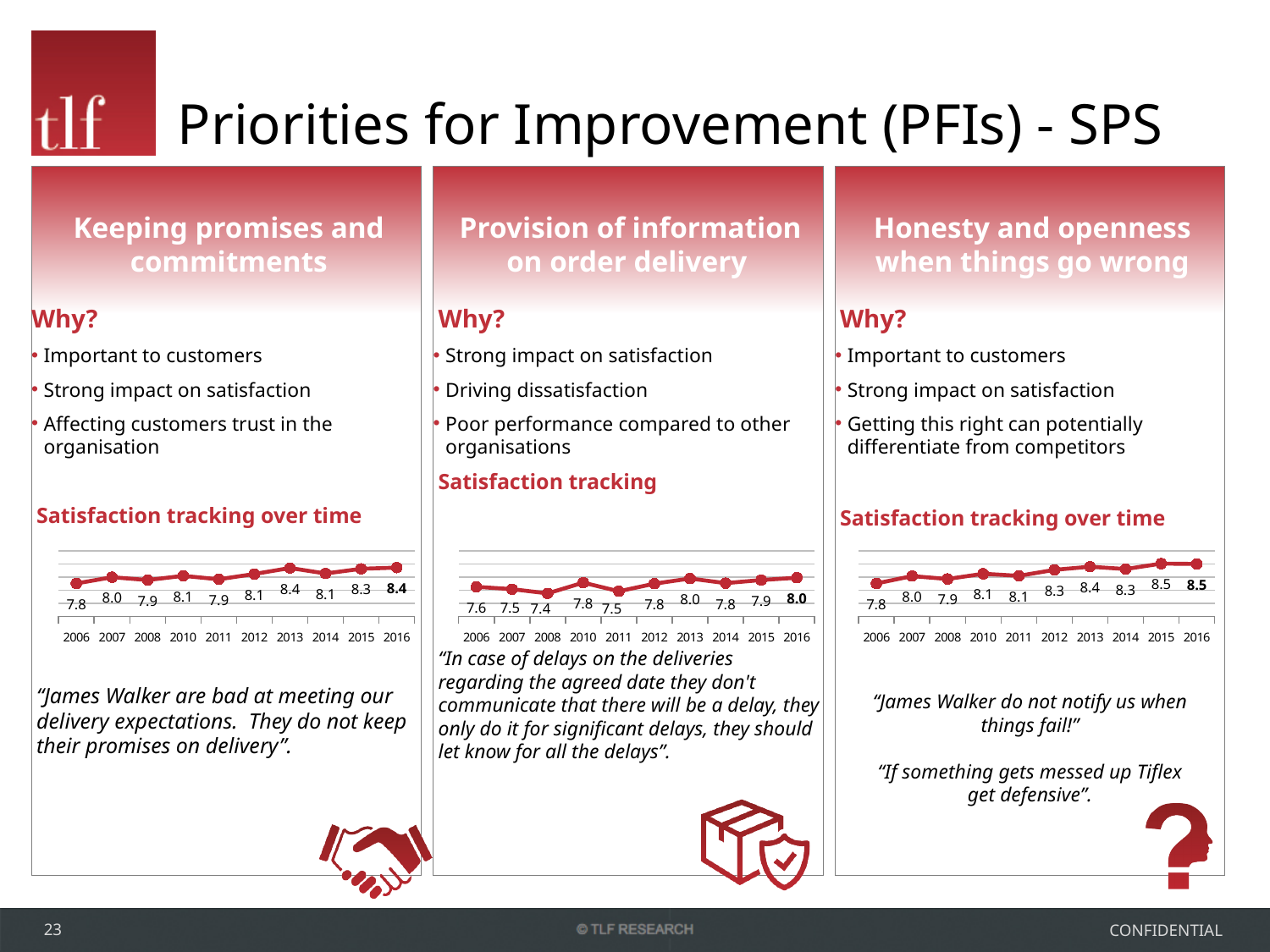
What type of chart is used in the 'Satisfaction tracking over time' section under 'Honesty and openness when things go wrong'? line chart In the 'Provision of information on order delivery' chart, is the value for 2013 larger or smaller than the value for 2011? larger What is the first year shown on the x axis of the 'Provision of information on order delivery' chart? 2006 In the 'Honesty and openness when things go wrong' chart, do the values generally rise or fall from 2006 to 2016? rise In the 'Provision of information on order delivery' chart, which year has the lowest value? 2008 In the 'Provision of information on order delivery' chart, what is the value for 2008? 7.4 In the 'Honesty and openness when things go wrong' chart, what is the difference between the 2016 value and the 2006 value? 0.7 In the 'Honesty and openness when things go wrong' chart, what is the value for 2015? 8.5 In the 'Keeping promises and commitments' chart, what is the value for 2013? 8.4 How many data points are plotted in the 'Keeping promises and commitments' chart? 10 In the 'Keeping promises and commitments' chart, what is the satisfaction value for 2016? 8.4 In the 'Keeping promises and commitments' chart, what is the difference between the 2016 value and the 2006 value? 0.6